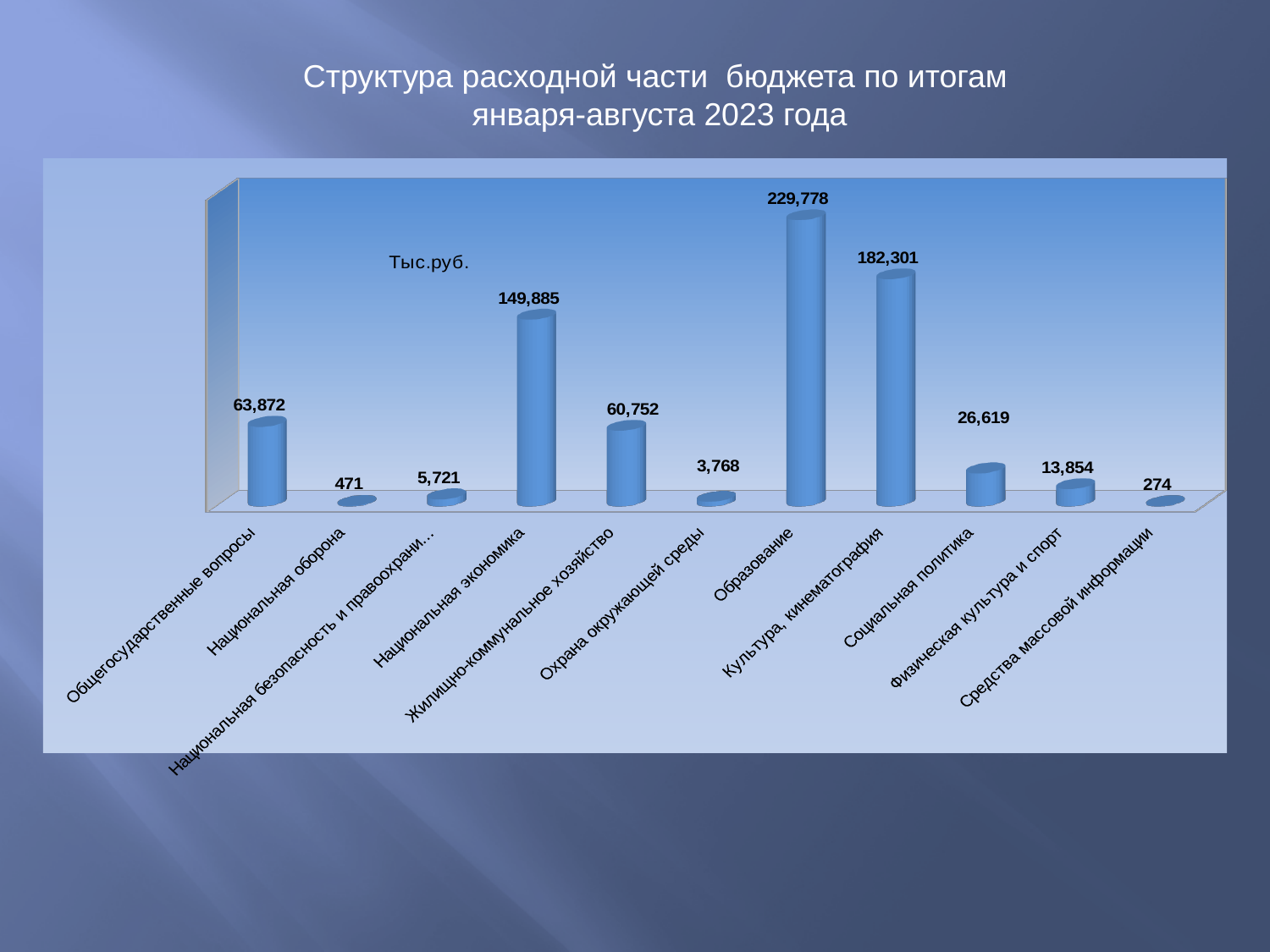
Which category has the highest value? Образование Which is larger, the value for Физическая культура и спорт or the value for Охрана окружающей среды? Физическая культура и спорт Which category has the lowest value? Средства массовой информации What is the difference between the values for Образование and Культура, кинематография? 47,477 What kind of chart is shown on the slide? Bar chart What value is shown for Образование? 229,778 What unit label is printed inside the chart area? Тыс.руб. What value is shown for Социальная политика? 26,619 What value is shown for Национальная оборона? 471 What is the difference between the values for Общегосударственные вопросы and Жилищно-коммунальное хозяйство? 3,120 What value is shown for Национальная экономика? 149,885 How many categories are shown in the chart? 11